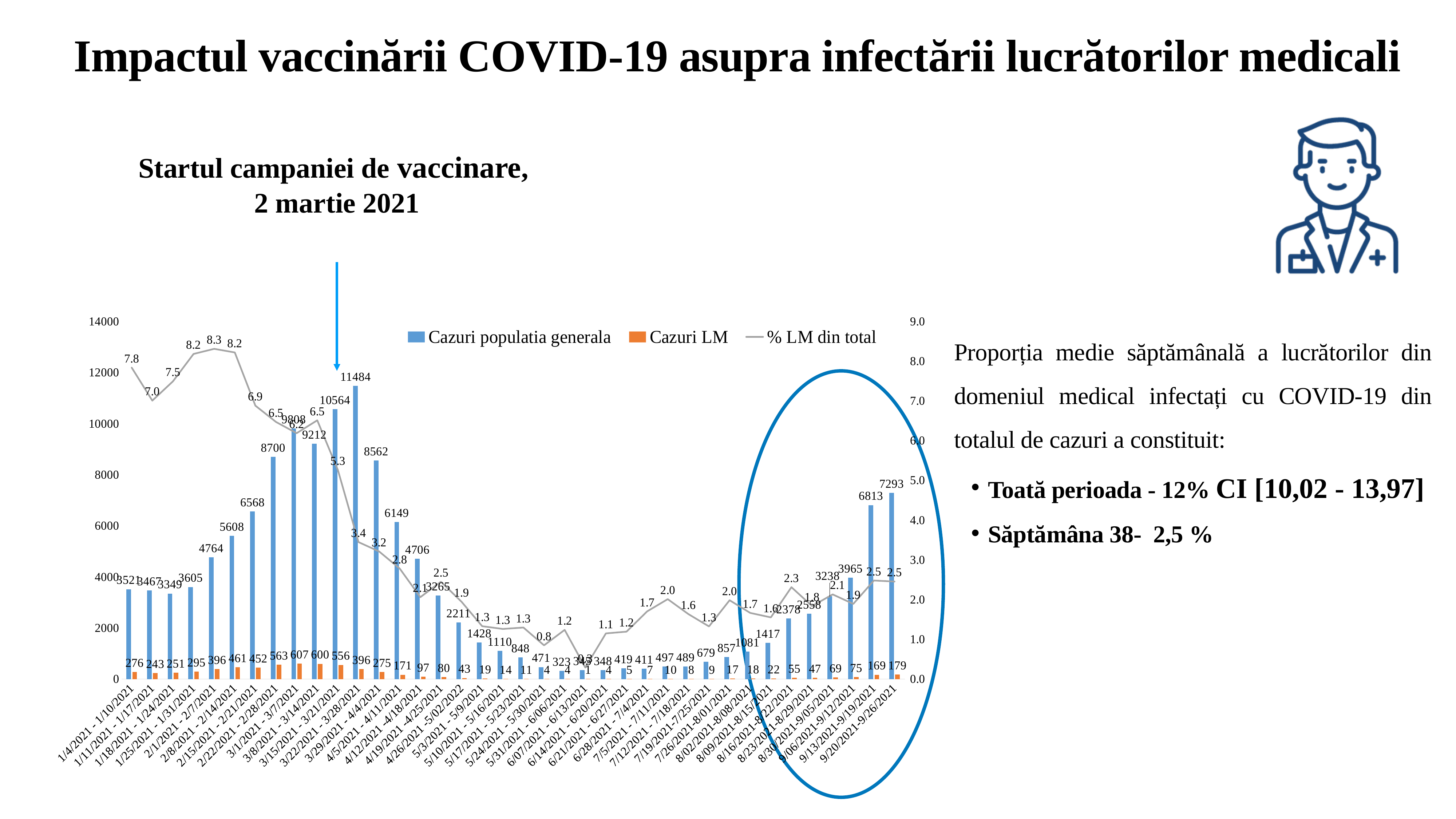
In which week is 'Cazuri LM' lowest? 6/07/2021 - 6/13/2021 In which week is 'Cazuri populatia generala' highest? 3/22/2021 - 3/28/2021 What is the value of 'Cazuri populatia generala' for the week 3/22/2021 - 3/28/2021? 11484 What is the '% LM din total' value for the week 2/1/2021 - 2/7/2021? 8.3 What is the difference in 'Cazuri populatia generala' between the weeks 9/20/2021 - 9/26/2021 and 9/13/2021 - 9/19/2021? 480 What type of chart is shown on the slide? Combined bar and line chart In which week is 'Cazuri LM' highest? 3/1/2021 - 3/7/2021 What is the name of the series drawn as a grey line? % LM din total How many weekly categories are plotted on the x axis? 38 How many series does the chart legend list? 3 What is the value of 'Cazuri LM' for the week 9/20/2021 - 9/26/2021? 179 Which is larger: 'Cazuri LM' for 3/8/2021 - 3/14/2021 or for 3/15/2021 - 3/21/2021? 3/8/2021 - 3/14/2021